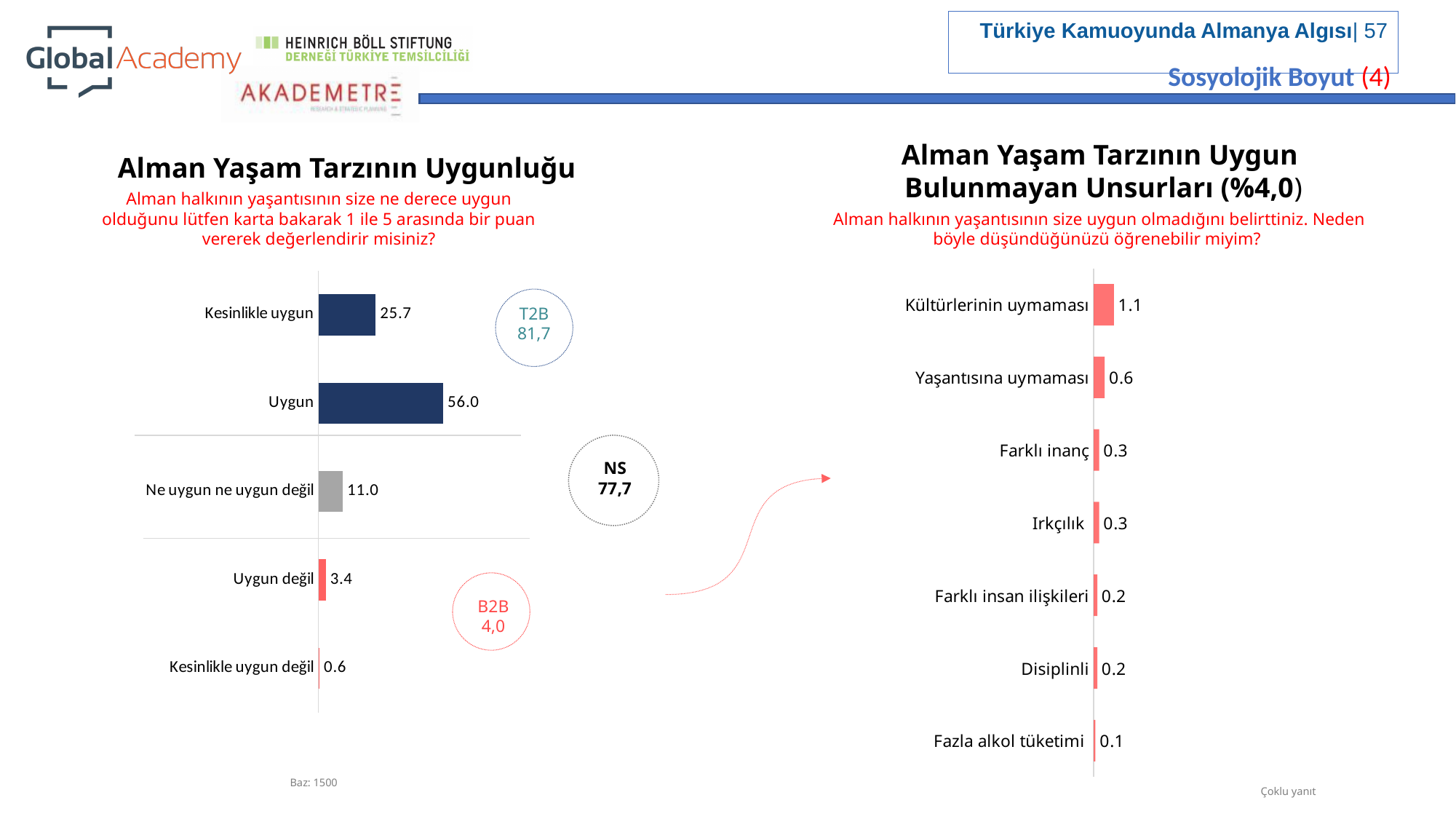
In the 'Alman Yaşam Tarzının Uygun Bulunmayan Unsurları' chart, which category has the lowest value? Fazla alkol tüketimi In the 'Alman Yaşam Tarzının Uygunluğu' chart, which category has the highest value? Uygun What type of chart is the 'Alman Yaşam Tarzının Uygun Bulunmayan Unsurları' chart? Bar chart In the 'Alman Yaşam Tarzının Uygunluğu' chart, how many categories are shown? 5 In the 'Alman Yaşam Tarzının Uygunluğu' chart, what is the value for 'Kesinlikle uygun'? 25.7 In the 'Alman Yaşam Tarzının Uygunluğu' chart, which category has the lowest value? Kesinlikle uygun değil In the 'Alman Yaşam Tarzının Uygun Bulunmayan Unsurları' chart, which is larger: 'Yaşantısına uymaması' or 'Farklı inanç'? Yaşantısına uymaması In the 'Alman Yaşam Tarzının Uygun Bulunmayan Unsurları' chart, how many categories are shown? 7 In the 'Alman Yaşam Tarzının Uygunluğu' chart, what is the value for 'Uygun'? 56.0 In the 'Alman Yaşam Tarzının Uygun Bulunmayan Unsurları' chart, what is the value for 'Kültürlerinin uymaması'? 1.1 In the 'Alman Yaşam Tarzının Uygunluğu' chart, what is the difference between 'Uygun' and 'Kesinlikle uygun'? 30.3 In the 'Alman Yaşam Tarzının Uygunluğu' chart, what is the T2B value shown in the circle? 81,7